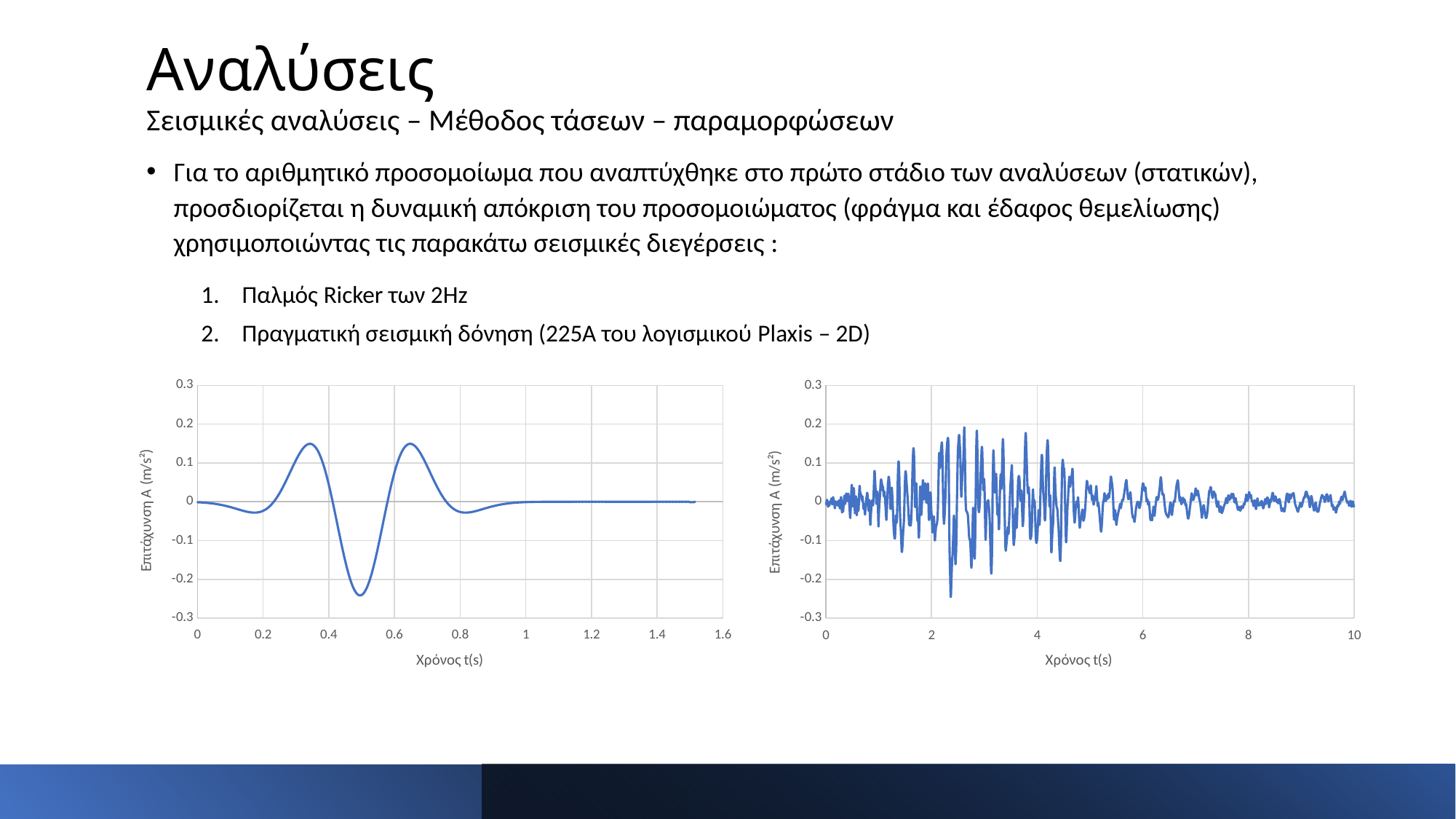
What is the x-axis label of the left chart? Χρόνος t(s) In the right chart, is the lowest value of the curve (near t = 2.3 s) greater or less than -0.2? less In the left chart, is the positive peak near t = 0.35 s greater or less than 0.1? greater In the left chart, is the value at t = 1.2 s greater or less than 0.1? less In the left chart, which is larger in magnitude: the largest positive peak or the largest negative trough? the negative trough What kind of chart is the left chart (Ricker pulse)? line chart What kind of chart is the right chart (real seismic record)? line chart In the right chart, does the amplitude of the oscillations increase or decrease from t = 4 s to t = 10 s? decrease How many charts are shown on the slide? 2 What is the y-axis label of the right chart? Επιτάχυνση A (m/s²)